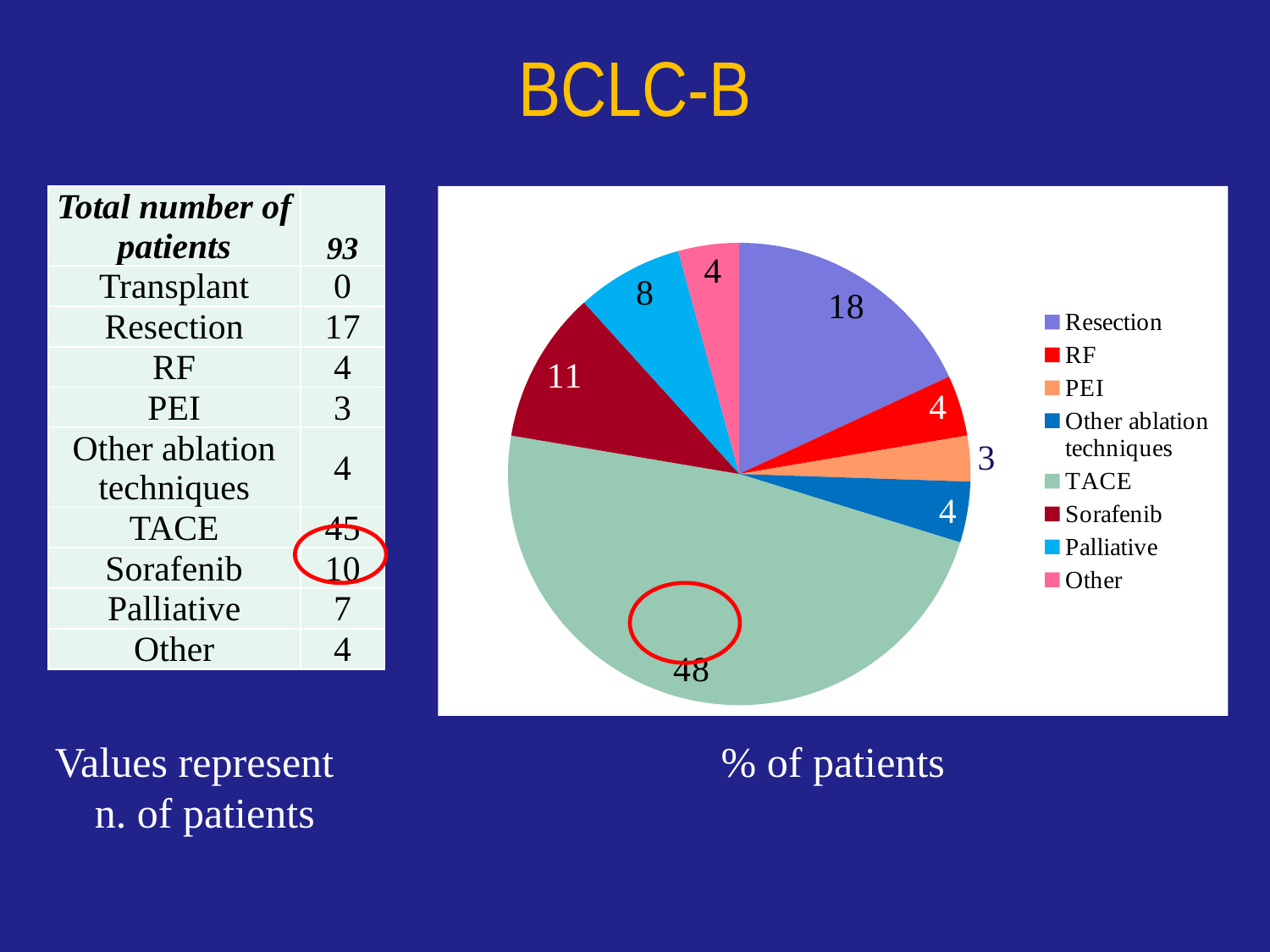
How many entries does the legend of the pie chart list? 8 Which category has the largest slice in the pie chart? TACE What colour is the TACE slice in the pie chart? light green What value is shown for the Sorafenib slice of the pie chart? 11 Which category has the smallest slice in the pie chart? PEI What value is shown for the Palliative slice of the pie chart? 8 Which is larger in the pie chart, Sorafenib or Palliative? Sorafenib What is the difference between the TACE value and the Resection value in the pie chart? 30 What value is shown for the PEI slice of the pie chart? 3 What type of chart is shown on the slide? pie chart What value is shown for the TACE slice of the pie chart? 48 What value is shown for the Resection slice of the pie chart? 18